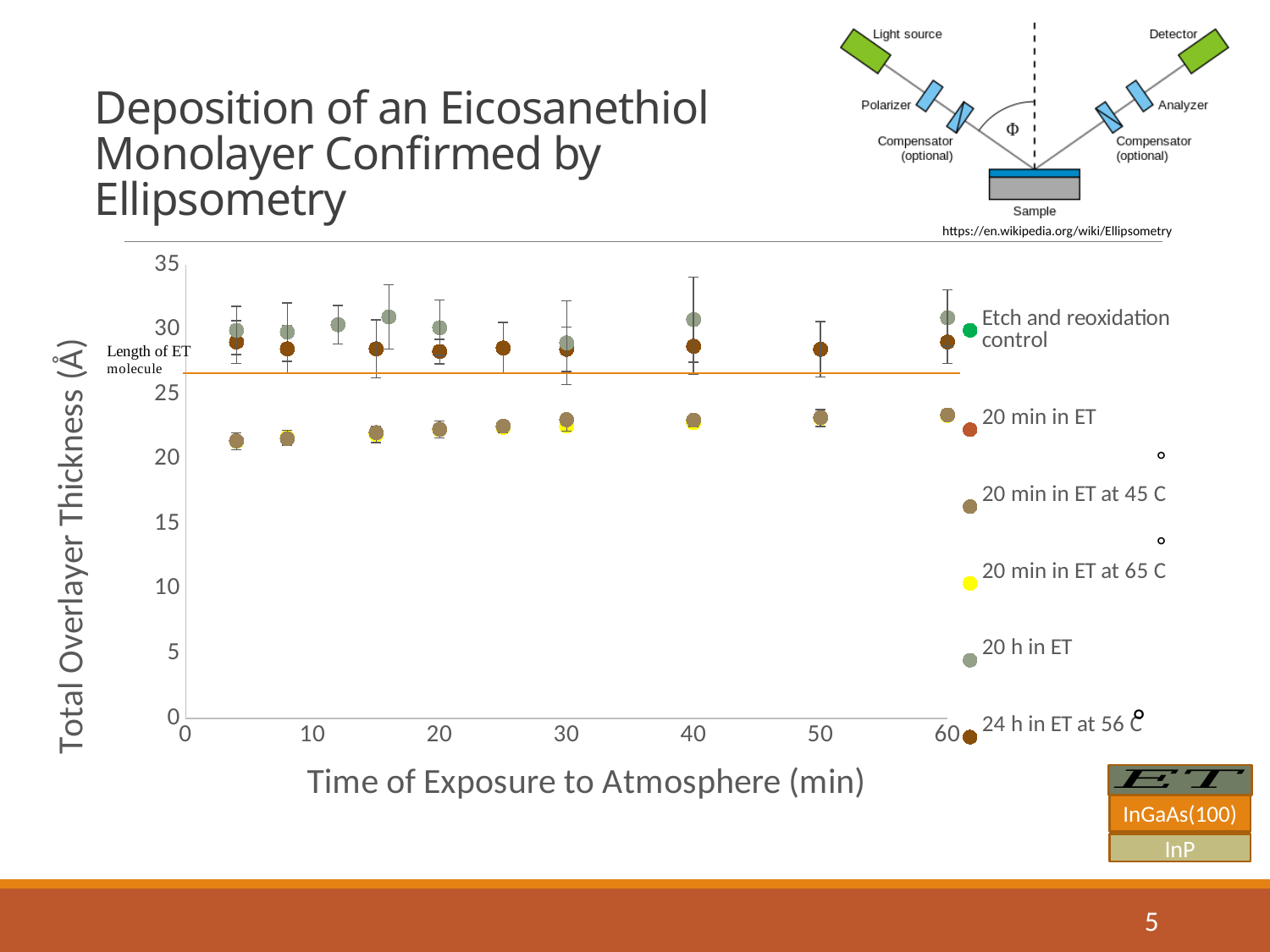
What kind of chart is shown on the slide? scatter chart Do the values for the 20 min in ET series rise or fall as time of exposure increases from 0 to 60 min? rise At 30 min, which series has the larger value: 20 h in ET or 20 min in ET at 65 C? 20 h in ET Is the value for the 20 h in ET series at 50 min greater or less than 25? greater Is the value for the 20 min in ET series at 60 min greater or less than 20? greater Is the value for the 24 h in ET at 56 C series at 40 min greater or less than 25? greater What is the title of the x axis? Time of Exposure to Atmosphere (min) How many series does the legend list? 6 What is the title of the y axis? Total Overlayer Thickness (Å)